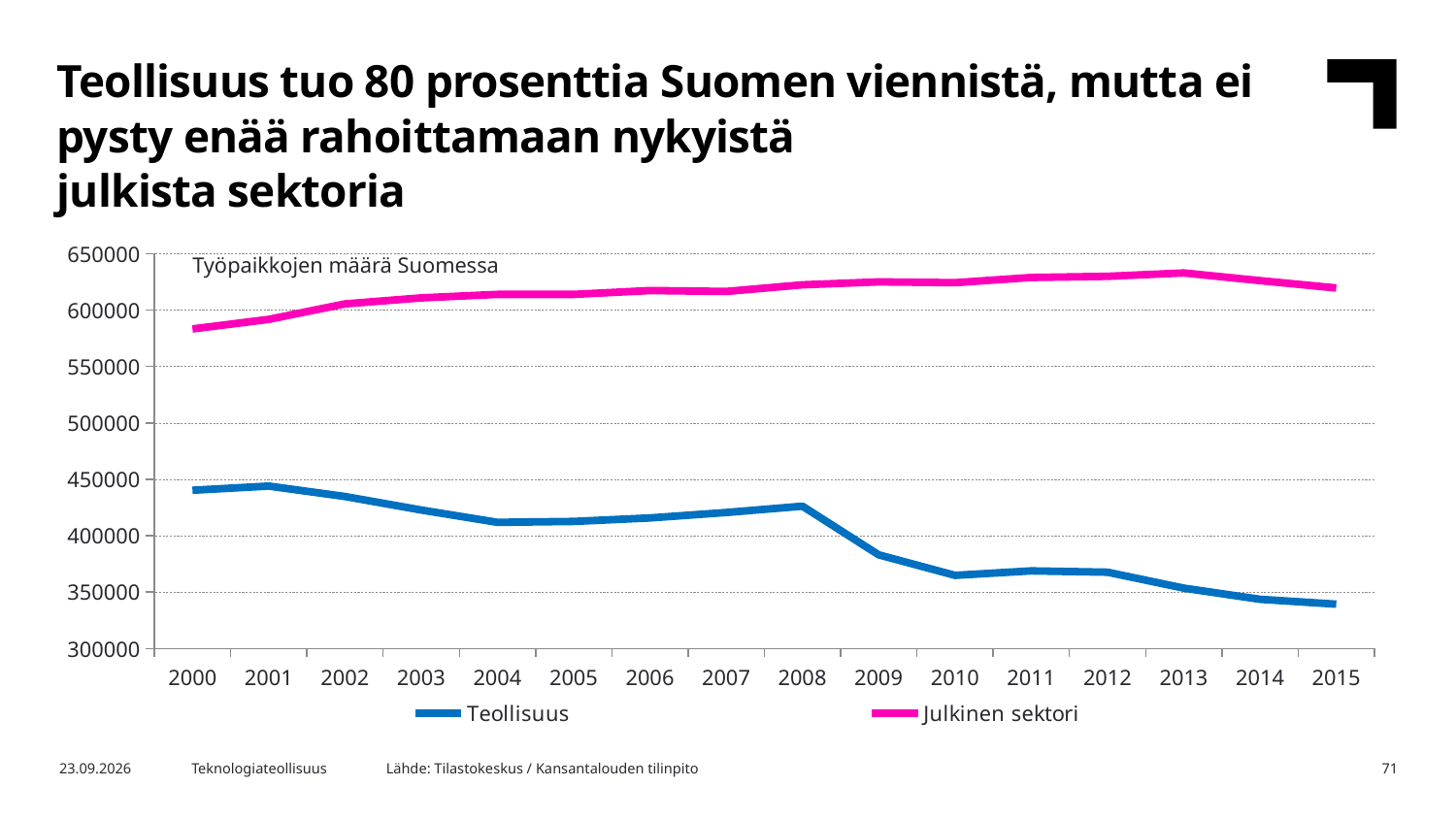
Which is larger, the Teollisuus value for 2008 or for 2010? 2008 How many series does the legend list? 2 How many years are shown on the x axis? 16 What kind of chart is shown on the slide? line chart In which year is the Julkinen sektori value highest? 2013 Does the Julkinen sektori series rise or fall overall from 2000 to 2015? rise Does the Teollisuus series rise or fall overall from 2000 to 2015? fall Which series is drawn in pink? Julkinen sektori What is the title printed inside the chart area? Työpaikkojen määrä Suomessa Is the Teollisuus value for 2015 greater or less than 350000? less Is the Julkinen sektori value for 2000 greater or less than 600000? less In which year is the Teollisuus value lowest? 2015